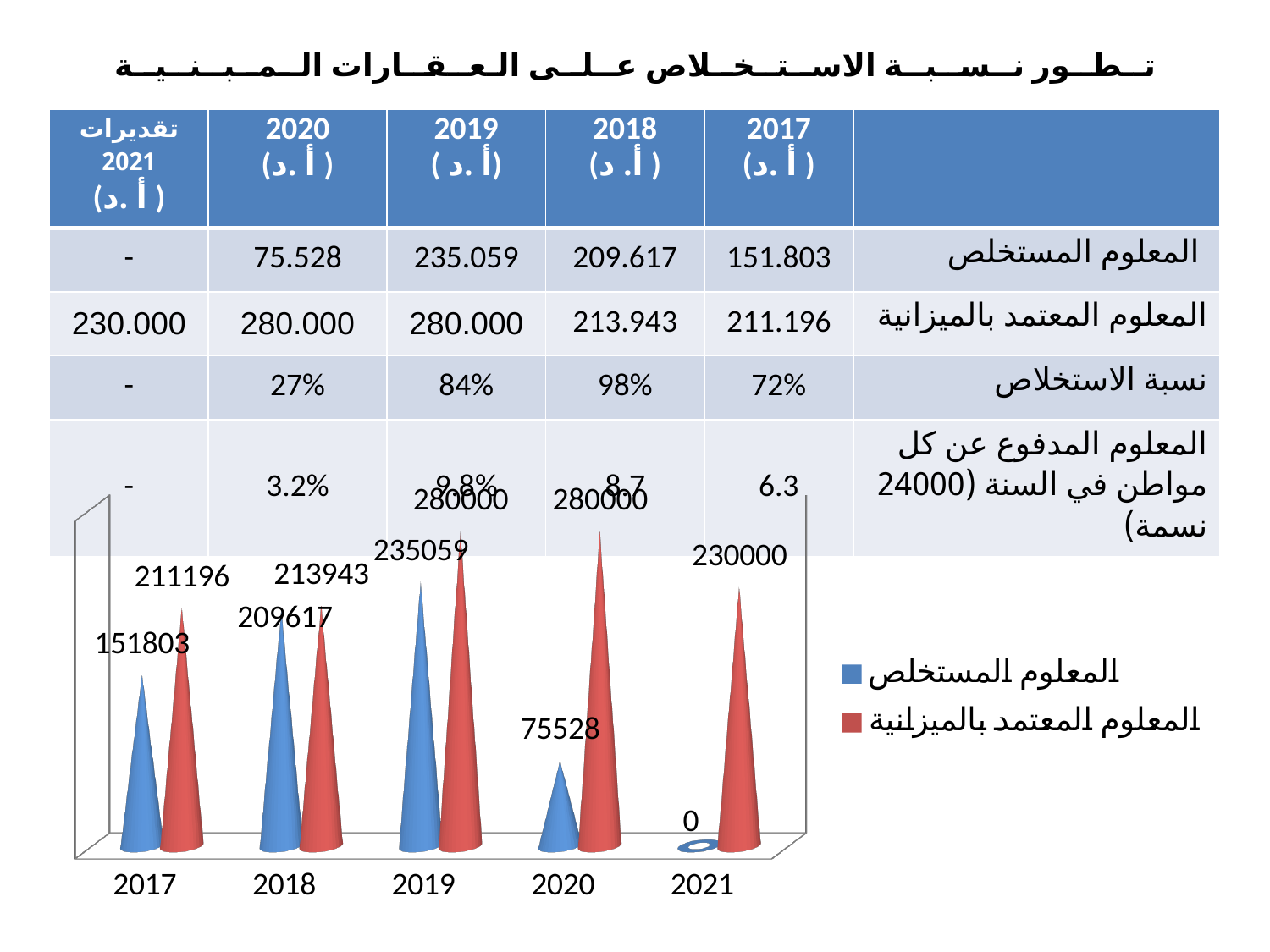
What is the value of المعلوم المستخلص for 2020 in the chart? 75528 How many years are shown on the x axis of the chart? 5 What is the value of المعلوم المعتمد بالميزانية for 2017 in the chart? 211196 What is the value of المعلوم المستخلص for 2019 in the chart? 235059 Which colour represents المعلوم المعتمد بالميزانية in the chart? red Which is larger in 2018: المعلوم المستخلص or المعلوم المعتمد بالميزانية? المعلوم المعتمد بالميزانية In which year is المعلوم المستخلص highest in the chart? 2019 In which year is المعلوم المستخلص lowest in the chart? 2021 What is the difference between المعلوم المعتمد بالميزانية and المعلوم المستخلص in 2020? 204472 How many series does the chart legend list? 2 What kind of chart is shown on the slide? bar chart What is the value of المعلوم المعتمد بالميزانية for 2021 in the chart? 230000